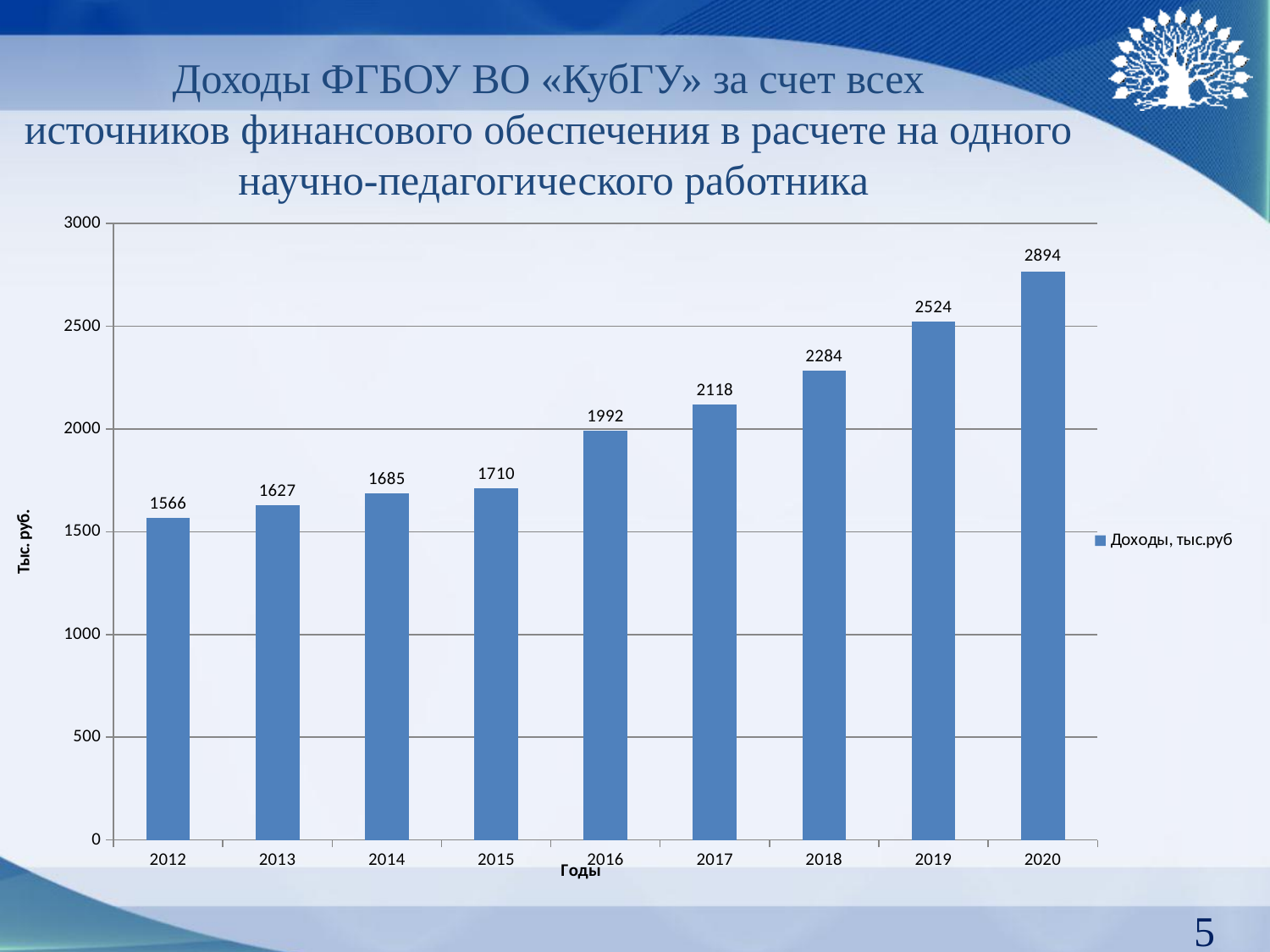
What is the value for 2019? 2524 What is the difference between the values for 2015 and 2014? 25 Is the value for 2016 greater or less than 1500? greater What kind of chart is shown on the slide? bar chart What is the value for 2012? 1566 How many years are shown on the x axis? 9 What is the value for 2016? 1992 Which year has the highest value? 2020 What is the difference between the values for 2020 and 2019? 370 Do the values rise or fall from 2012 to 2020? rise Which is larger, the value for 2017 or the value for 2018? 2018 Which year has the lowest value? 2012